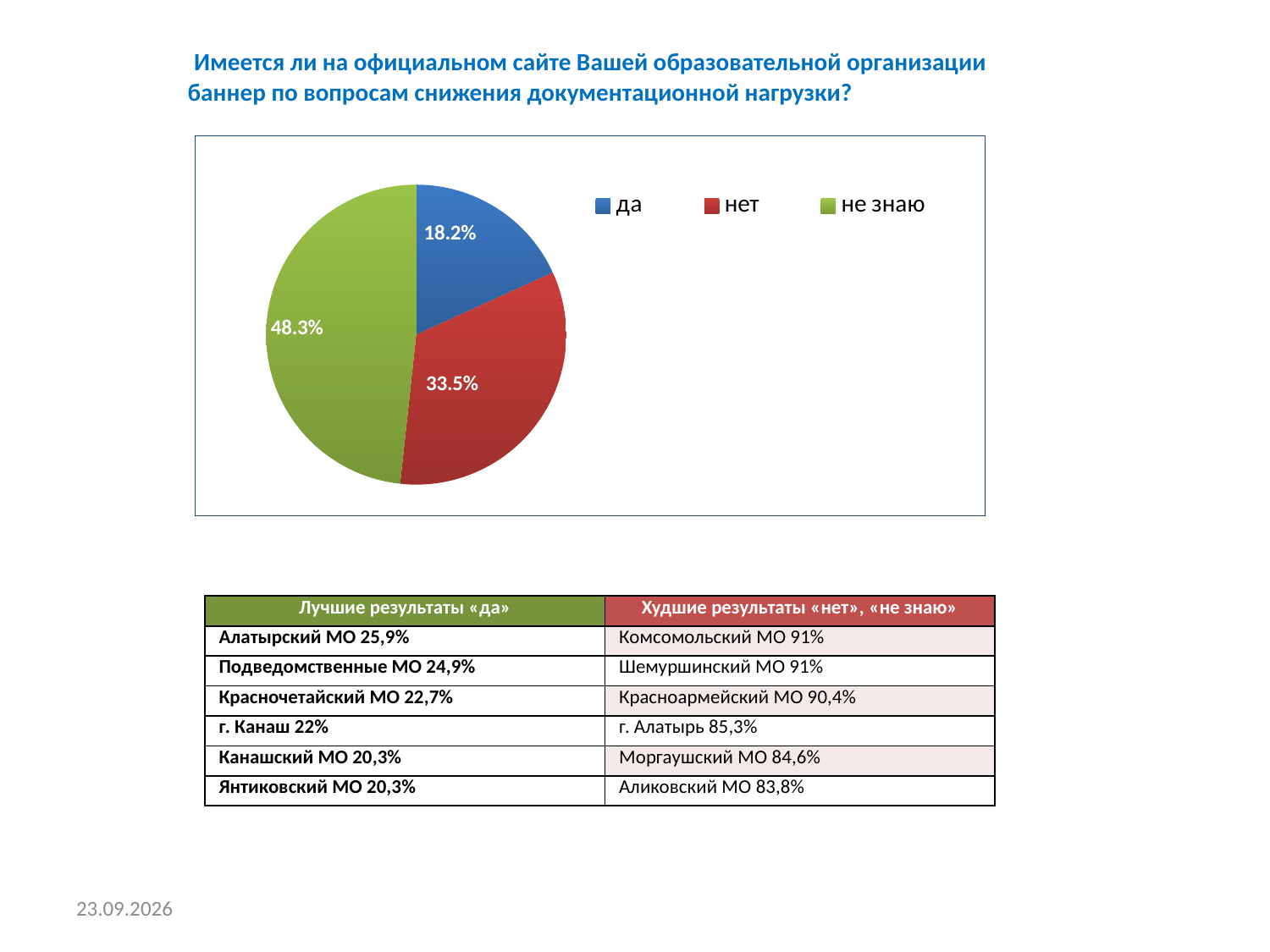
What share of the pie does the "не знаю" slice represent? 48.3% Which slice is larger, "нет" or "да"? нет What colour is the "не знаю" slice in the pie chart? green What kind of chart is shown on the slide? pie chart What is the difference in percentage points between the "не знаю" slice and the "да" slice? 30.1 What share of the pie does the "да" slice represent? 18.2% Which answer option has the largest slice of the pie? не знаю What is the difference in percentage points between the "нет" slice and the "да" slice? 15.3 Which answer option has the smallest slice of the pie? да How many entries does the legend list? 3 How many slices does the pie chart have? 3 What share of the pie does the "нет" slice represent? 33.5%